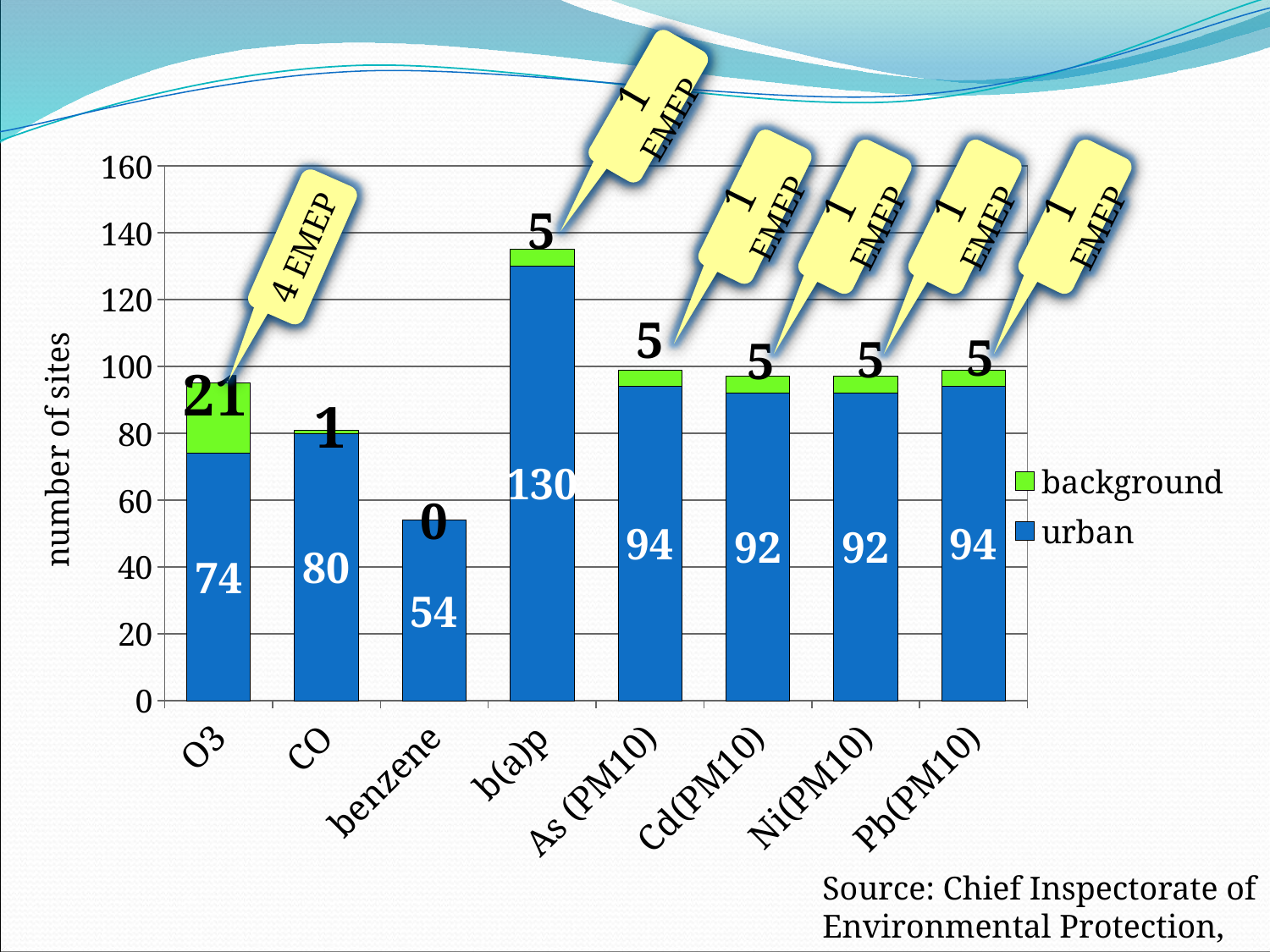
What is the urban value for benzene? 54 What is the difference between the urban values for b(a)p and CO? 50 How many categories are shown on the x axis? 8 What kind of chart is shown on the slide? stacked bar chart What is the background value for O3? 21 What is the total number of sites for O3 (urban plus background)? 95 Which category has the highest urban value? b(a)p Which category has the lowest urban value? benzene What is the background value for CO? 1 Which is larger, the urban value for As (PM10) or the urban value for Cd(PM10)? As (PM10) How many series does the legend list? 2 What is the urban value for b(a)p? 130